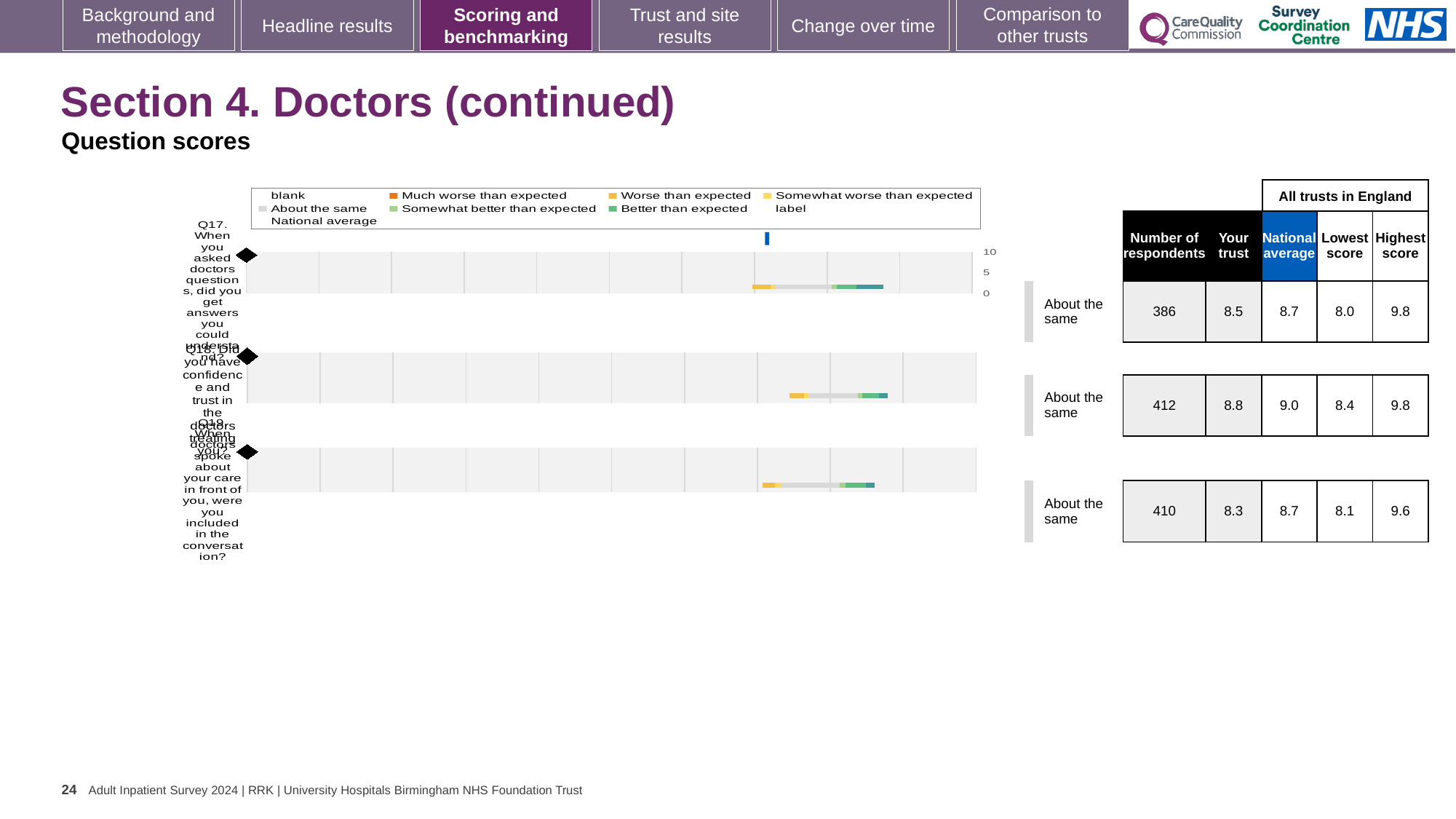
For Q18, what is the difference between the highest score and the lowest score among all trusts in England? 1.4 What benchmarking category is shown for Q18? About the same What is the 'Your trust' score for Q17 (When you asked doctors questions, did you get answers you could understand?)? 8.5 For Q19, how much higher is the national average than the 'Your trust' score? 0.4 Which question has the highest 'Your trust' score? Q18 How many questions are plotted on this slide? 3 Which question has the lowest 'Your trust' score? Q19 For Q17, which is larger: the 'Your trust' score or the national average? National average Is the 'Your trust' score for Q17 greater or less than 5 on the chart axis? greater What is the national average score for Q18 (Did you have confidence and trust in the doctors treating you?)? 9.0 What is the lowest score among all trusts in England for Q17? 8.0 How many respondents answered Q19 (When doctors spoke about your care in front of you, were you included in the conversation?)? 410